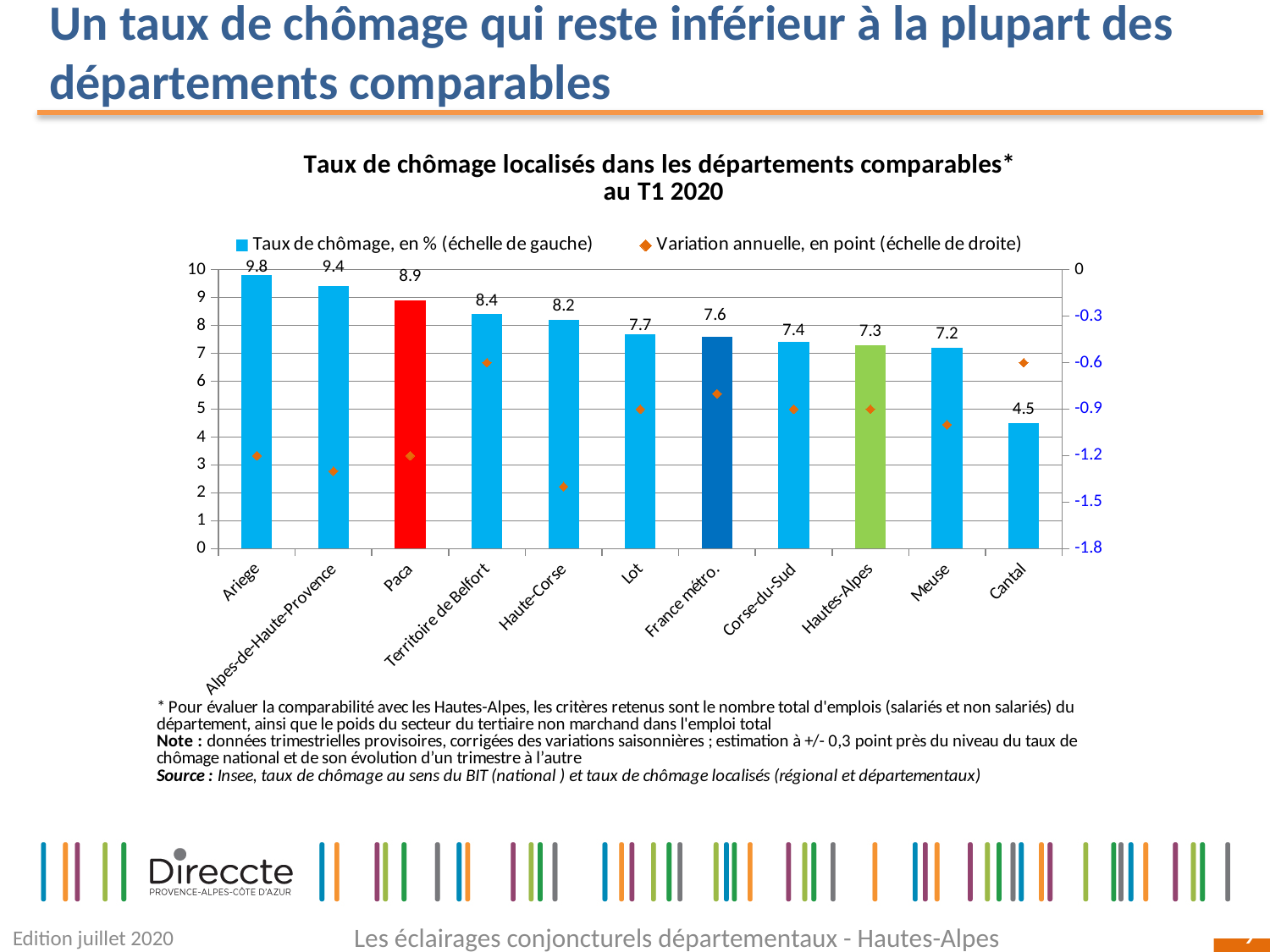
What is the unemployment rate shown for France métro.? 7.6 Which department has the highest unemployment rate on the chart? Ariège What is the unemployment rate (taux de chômage, en %) shown for Ariège? 9.8 How many departments or areas are shown on the x axis of the chart? 11 What is the difference between the unemployment rates of Ariège and Cantal? 5.3 Is the annual variation (variation annuelle, en point) for Haute-Corse greater or less than -1.2? less What is the unemployment rate shown for Hautes-Alpes? 7.3 Which department has the lowest unemployment rate on the chart? Cantal Do the unemployment rate bars rise or fall from left to right along the x axis? fall What kind of chart is used to show the unemployment rates? bar chart How many series does the chart legend list? 2 Which has a higher unemployment rate, Paca or Haute-Corse? Paca